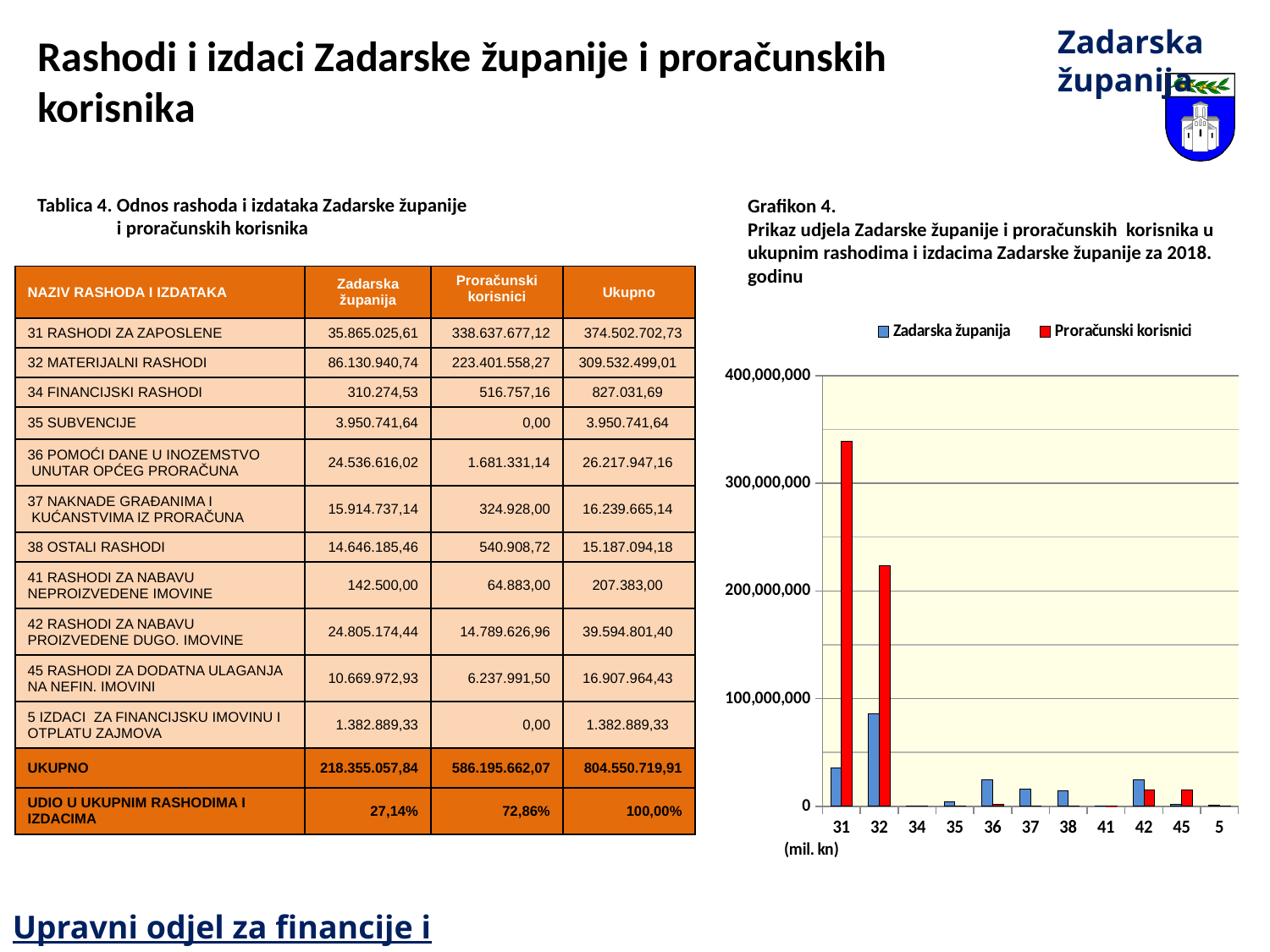
In Grafikon 4, is the Proračunski korisnici value for category 32 greater or less than 200,000,000? greater How many series does the legend of Grafikon 4 list? 2 How many categories are shown on the x axis of Grafikon 4? 11 In Grafikon 4, for category 36, which series has the larger value: Zadarska županija or Proračunski korisnici? Zadarska županija In Grafikon 4, for category 31, which series has the larger value: Zadarska županija or Proračunski korisnici? Proračunski korisnici In Grafikon 4, which series is shown in red? Proračunski korisnici What kind of chart is Grafikon 4? bar chart In Grafikon 4, is the Zadarska županija value for category 32 greater or less than 100,000,000? less In Grafikon 4, which category has the highest value for Zadarska županija? 32 In Grafikon 4, is the Proračunski korisnici value for category 31 greater or less than 300,000,000? greater What is the highest value shown on the y axis of Grafikon 4? 400,000,000 In Grafikon 4, which category has the highest value for Proračunski korisnici? 31